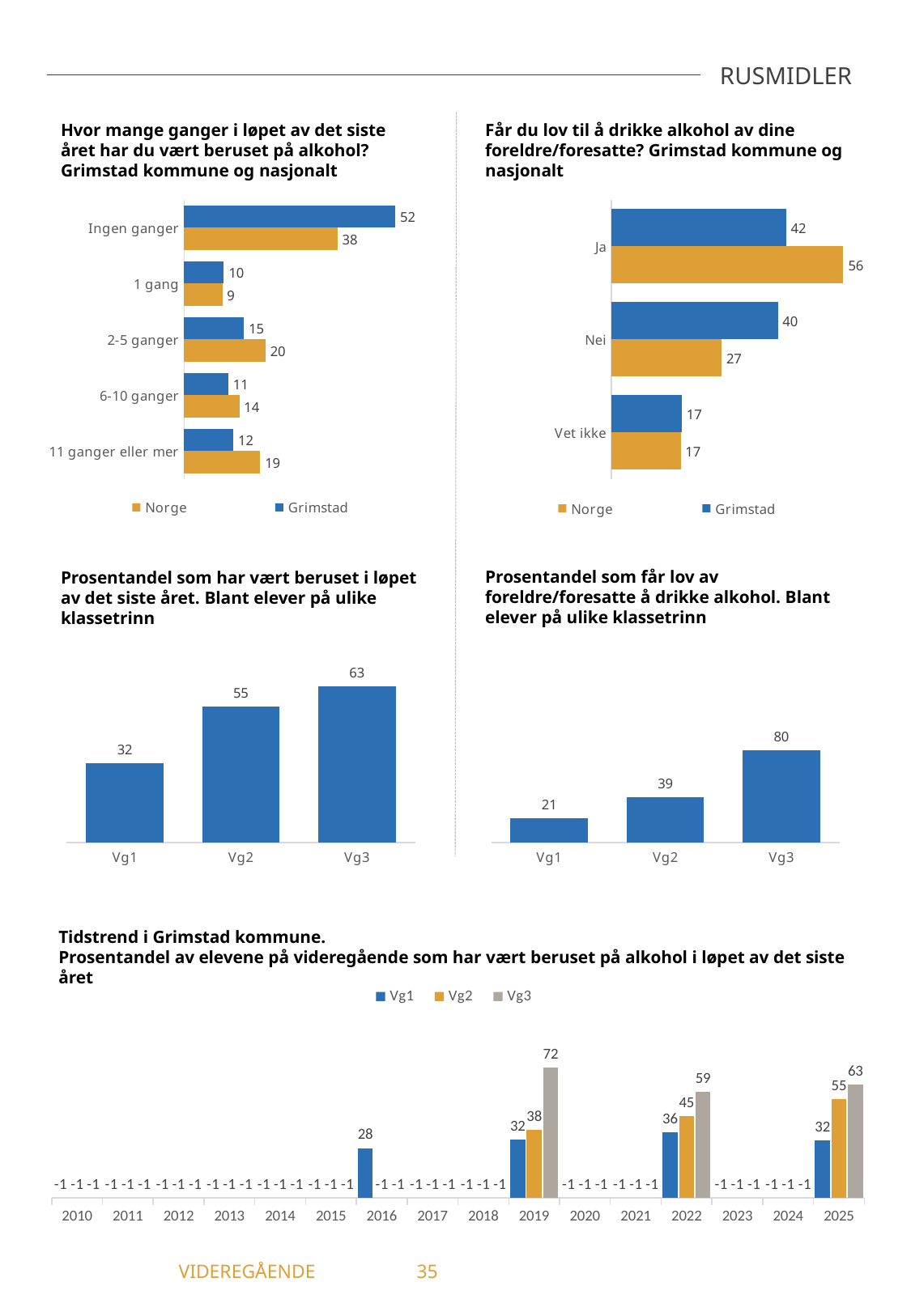
In the middle-left chart 'Prosentandel som har vært beruset i løpet av det siste året', which class level has the highest value? Vg3 In the middle-left chart 'Prosentandel som har vært beruset i løpet av det siste året', what is the value for Vg2? 55 In the top-left chart 'Hvor mange ganger i løpet av det siste året har du vært beruset på alkohol?', what is the difference between the Norge and Grimstad values for '11 ganger eller mer'? 7 In the top-right chart 'Får du lov til å drikke alkohol av dine foreldre/foresatte?', what is the value for Norge for 'Ja'? 56 In the bottom chart 'Tidstrend i Grimstad kommune', what is the value for Vg3 in 2019? 72 In the top-right chart 'Får du lov til å drikke alkohol av dine foreldre/foresatte?', which is larger for 'Nei': Grimstad or Norge? Grimstad What kind of chart is the bottom chart 'Tidstrend i Grimstad kommune'? bar chart In the top-right chart 'Får du lov til å drikke alkohol av dine foreldre/foresatte?', how many series does the legend list? 2 In the middle-right chart 'Prosentandel som får lov av foreldre/foresatte å drikke alkohol', do the values rise or fall from Vg1 to Vg3? rise In the top-left chart 'Hvor mange ganger i løpet av det siste året har du vært beruset på alkohol?', what is the value for Grimstad for 'Ingen ganger'? 52 In the middle-right chart 'Prosentandel som får lov av foreldre/foresatte å drikke alkohol', what is the difference between Vg3 and Vg1? 59 In the top-left chart 'Hvor mange ganger i løpet av det siste året har du vært beruset på alkohol?', how many categories are shown? 5